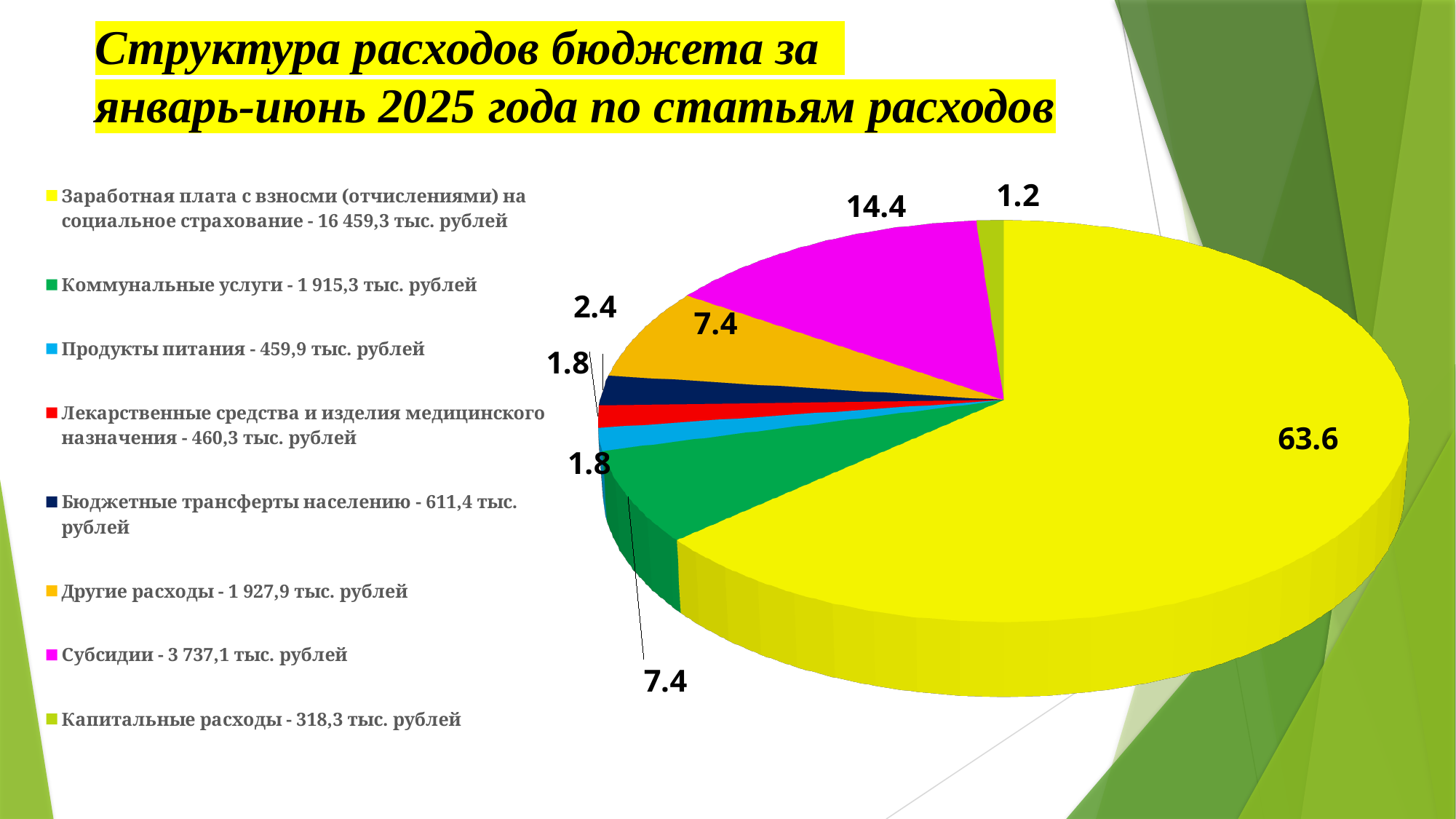
Which category has the largest slice of the pie? Заработная плата с взносми (отчислениями) на социальное страхование What is the data label on the slice for Бюджетные трансферты населению? 2.4 What kind of chart is shown on the slide? pie chart Which category has the smallest slice of the pie? Капитальные расходы How many categories does the legend of the pie chart list? 8 What is the data label on the slice for Субсидии? 14.4 What colour is the slice for Субсидии? magenta What is the difference between the data labels for Субсидии and Коммунальные услуги? 7.0 According to the legend, what amount is given for Коммунальные услуги? 1 915,3 тыс. рублей What is the data label on the slice for Заработная плата с взносми (отчислениями) на социальное страхование? 63.6 Which slice is larger: Субсидии or Другие расходы? Субсидии What is the data label on the slice for Капитальные расходы? 1.2